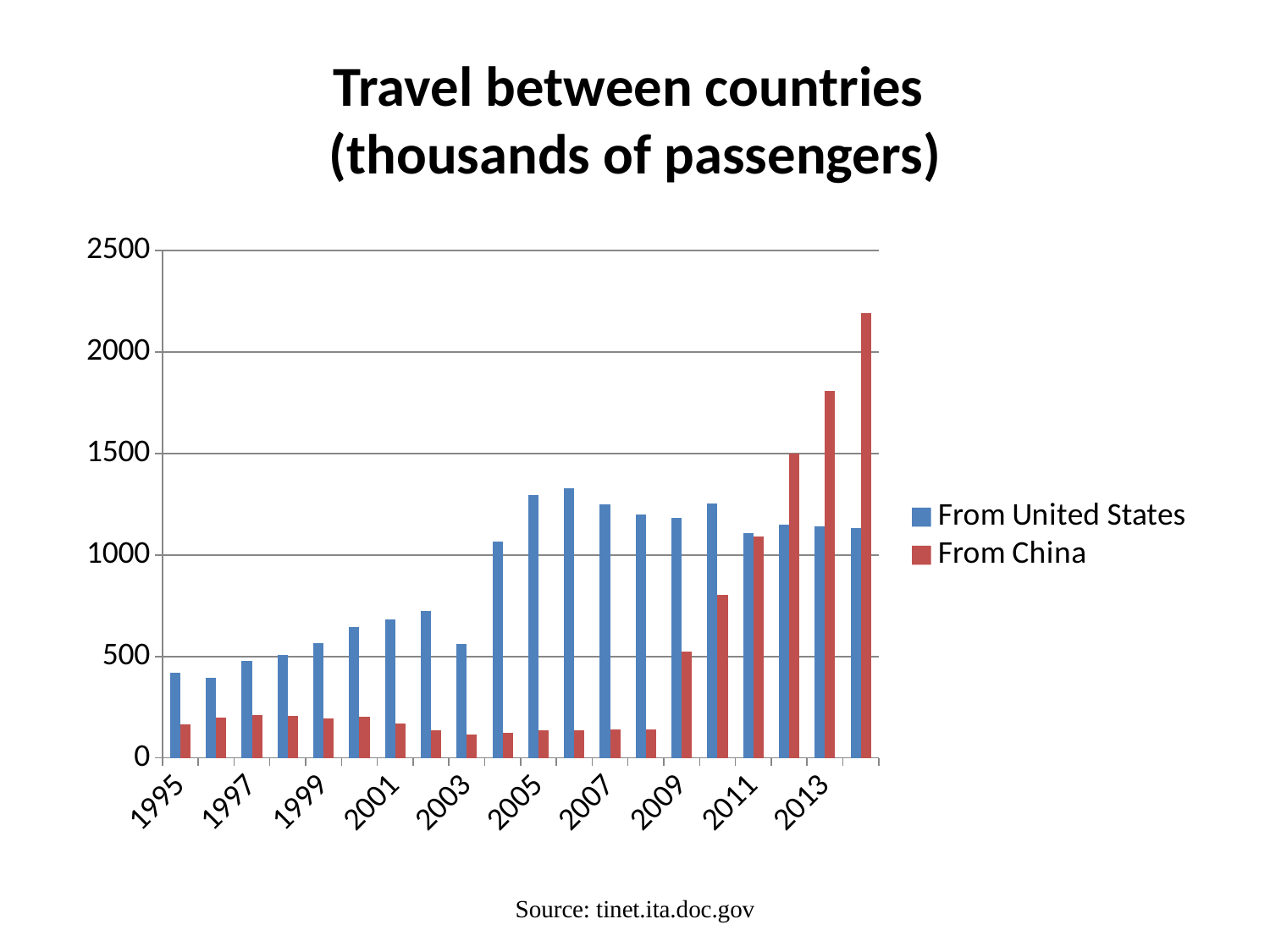
Do the From China values rise or fall from 2009 to 2013? rise Is the value for From United States in 1995 greater or less than 500? less Is the value for From United States in 2005 greater or less than 1000? greater Is the value for From China in 2007 greater or less than 500? less What kind of chart is shown on the slide? bar chart In 2005, which series has the larger value, From United States or From China? From United States What are the two series named in the legend? From United States, From China What colour are the bars for the From China series? red How many series does the legend list? 2 How many years are labeled on the x axis? 10 In 2013, which series has the larger value, From United States or From China? From China